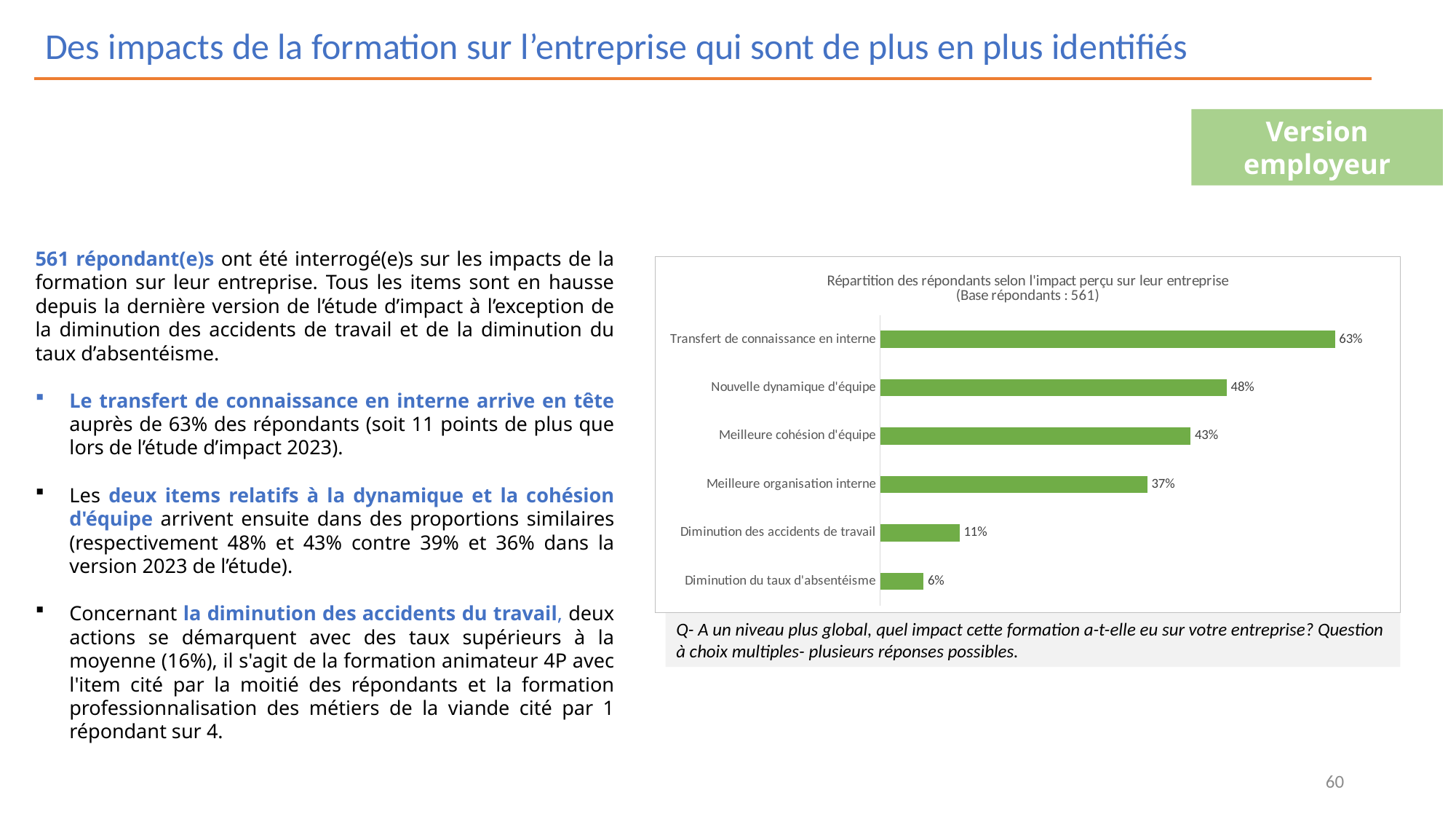
What is the value for "Nouvelle dynamique d'équipe"? 48% Which category has the highest value? Transfert de connaissance en interne What is the value for "Transfert de connaissance en interne"? 63% What kind of chart is shown on the slide? Bar chart Which category has the lowest value? Diminution du taux d'absentéisme Which is larger: "Meilleure organisation interne" or "Diminution des accidents de travail"? Meilleure organisation interne What is the difference between "Nouvelle dynamique d'équipe" and "Meilleure cohésion d'équipe"? 5% What is the value for "Diminution du taux d'absentéisme"? 6% What is the difference between "Transfert de connaissance en interne" and "Diminution des accidents de travail"? 52% How many categories are shown in the chart? 6 What is the base number of respondents stated in the chart title? 561 What is the value for "Meilleure organisation interne"? 37%